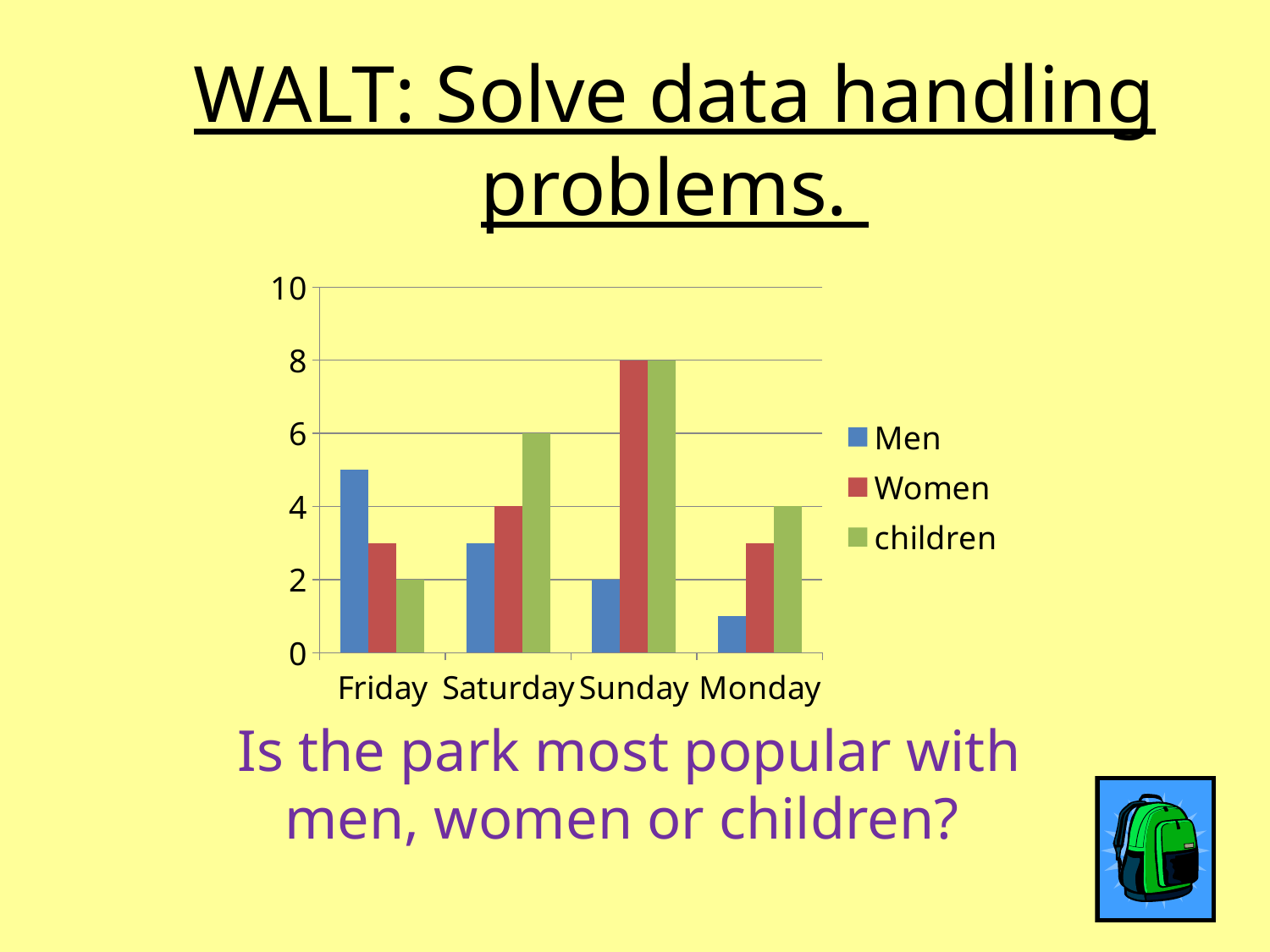
What is the value for children on Monday? 4 How many days are shown on the x axis? 4 On which day is the children bar highest? Sunday Is the value for Men on Friday greater or less than 4? greater Which is larger: the children value on Saturday or the children value on Friday? Saturday What is the value for Women on Saturday? 4 What is the value for children on Sunday? 8 What is the difference between the Women and Men values on Sunday? 6 What kind of chart is shown on the slide? bar chart How many series does the legend list? 3 What is the value for Men on Sunday? 2 On which day is the Men bar lowest? Monday